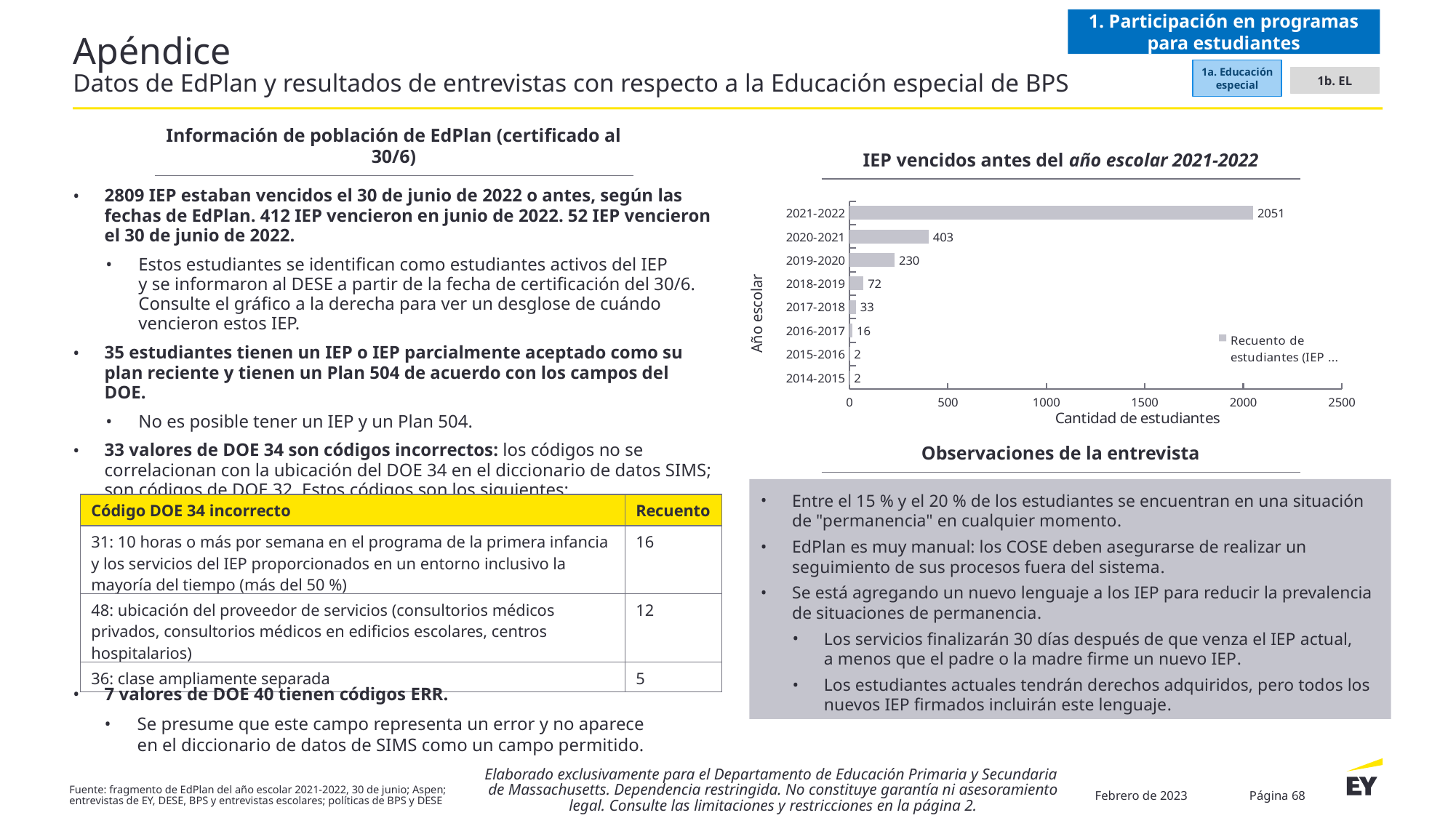
¿Qué tipo de gráfico se muestra en la diapositiva? Gráfico de barras ¿Cuál es la diferencia entre los valores de 2020-2021 y 2019-2020? 173 ¿Qué valor es mayor, el de 2020-2021 o el de 2018-2019? 2020-2021 ¿Qué año escolar tiene el valor más alto en el gráfico? 2021-2022 ¿Cuál es el título del gráfico? IEP vencidos antes del año escolar 2021-2022 ¿El valor para 2021-2022 es mayor o menor que 2000? mayor ¿Cuál es el valor para el año escolar 2019-2020? 230 ¿Cuál es el título del eje horizontal del gráfico? Cantidad de estudiantes ¿Cuál es el valor para el año escolar 2017-2018? 33 ¿Cuál es el valor para el año escolar 2021-2022 en el gráfico de IEP vencidos? 2051 ¿Cuántos años escolares se muestran en el gráfico? 8 ¿Cuál es la diferencia entre los valores de 2018-2019 y 2016-2017? 56